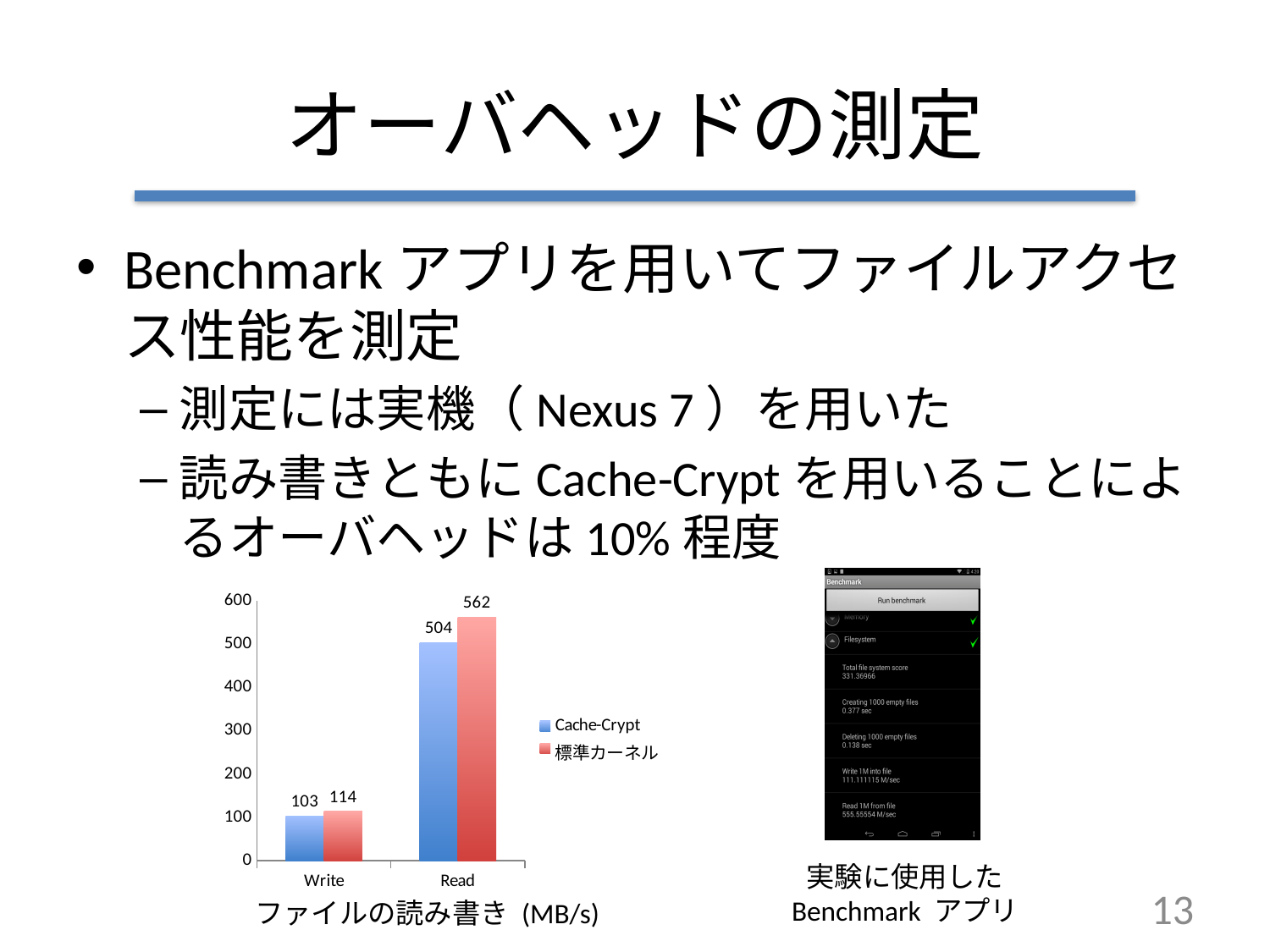
What is the difference between the 標準カーネル and Cache-Crypt values for Write? 11 Which category has the lowest Cache-Crypt value? Write What is the 標準カーネル value for Read? 562 What is the Cache-Crypt value for Read? 504 Which category has the highest 標準カーネル value? Read What is the Cache-Crypt value for Write? 103 How many categories are shown on the x axis? 2 How many series does the legend list? 2 What is the difference between the 標準カーネル and Cache-Crypt values for Read? 58 What is the 標準カーネル value for Write? 114 What kind of chart is shown on the slide? bar chart For Read, which series has the larger value, Cache-Crypt or 標準カーネル? 標準カーネル